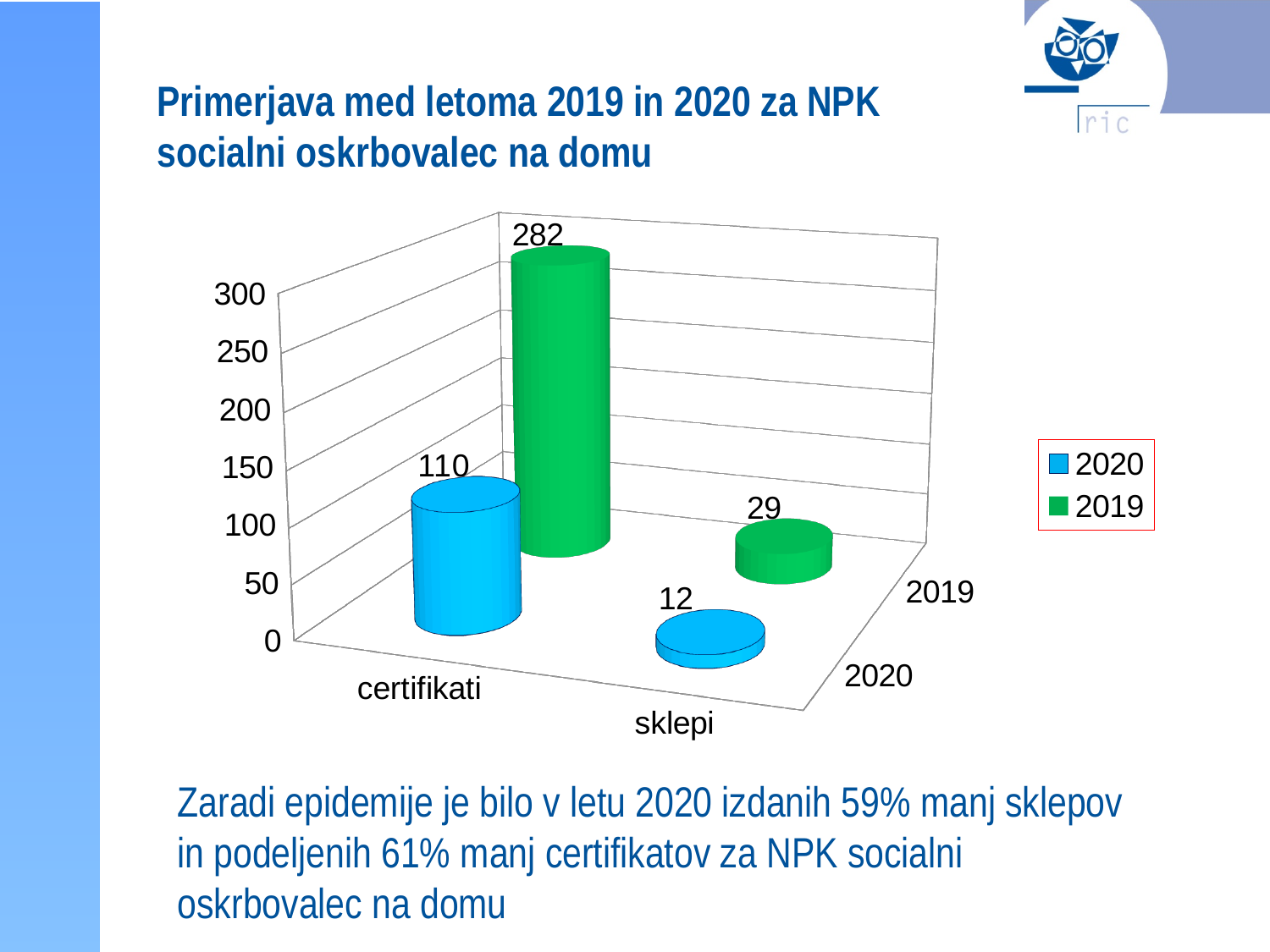
How many series does the legend list? 2 How many categories are shown on the x axis of the chart? 2 What is the value for certifikati in 2020? 110 Which category has the lowest value in the 2020 series? sklepi What kind of chart is shown on the slide? bar chart What is the difference between the 2019 and 2020 values for sklepi? 17 What is the value for sklepi in 2020? 12 Which category has the highest value in the 2019 series? certifikati What is the value for certifikati in 2019? 282 What is the difference between the 2019 and 2020 values for certifikati? 172 What is the value for sklepi in 2019? 29 Which is larger: the value for sklepi in 2019 or the value for certifikati in 2020? certifikati in 2020